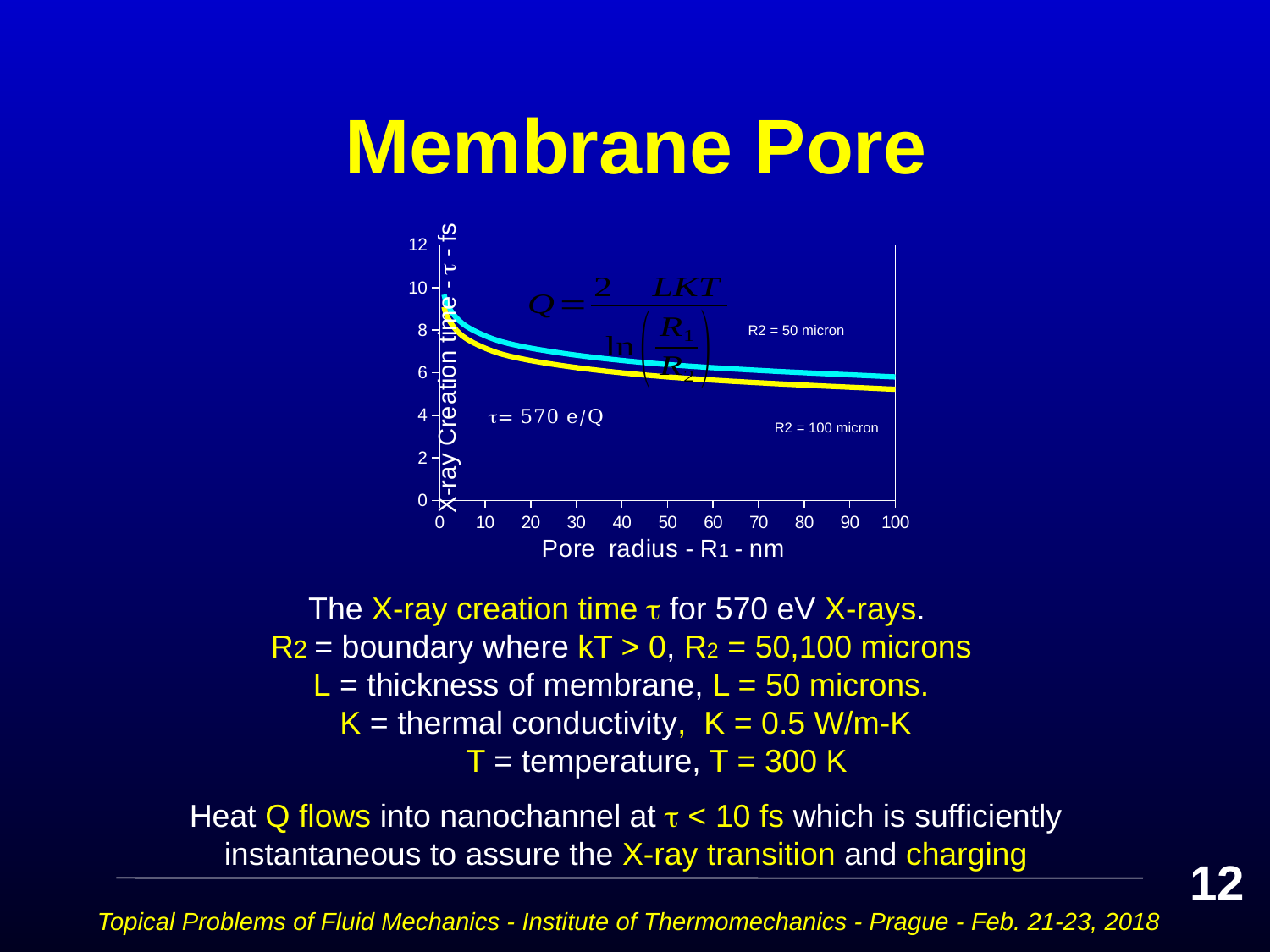
Do the curves rise or fall as the pore radius R1 increases? fall What is the label of the y axis of the chart? X-ray Creation time - τ - fs Is the X-ray creation time for R2 = 100 micron at a pore radius of 20 nm greater or less than 6 fs? greater What type of chart is shown on the slide? line chart How many curves are plotted on the chart? 2 What is the label of the x axis of the chart? Pore radius - R1 - nm What is the largest value shown on the x axis of the chart? 100 Is the X-ray creation time for R2 = 50 micron at a pore radius of 10 nm greater or less than 10 fs? less Is the X-ray creation time for R2 = 100 micron at a pore radius of 100 nm greater or less than 6 fs? less